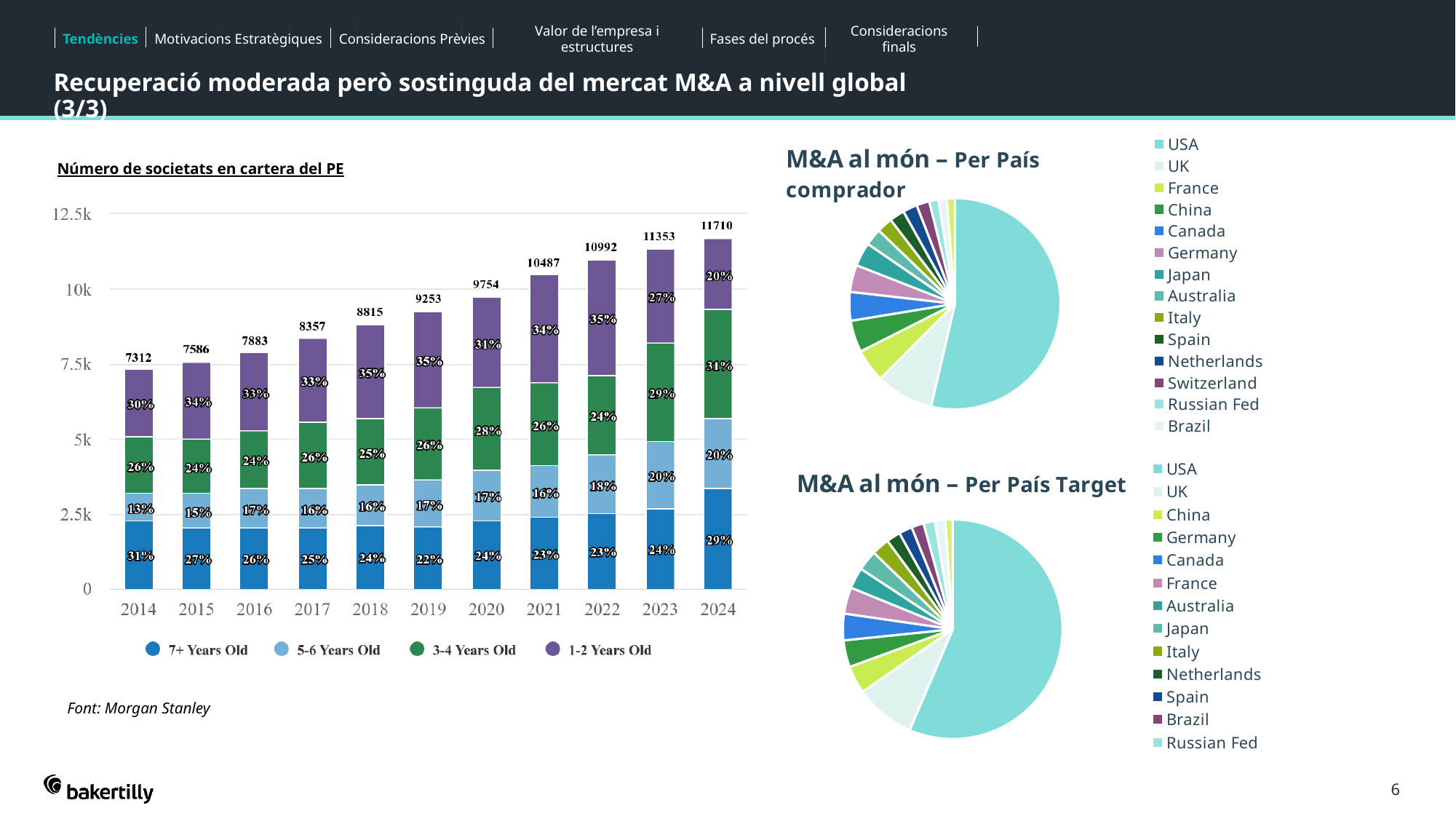
In the chart 'Número de societats en cartera del PE', what percentage does the '7+ Years Old' segment represent in 2014? 31% In the chart 'Número de societats en cartera del PE', which year has a larger total, 2019 or 2020? 2020 In the chart 'Número de societats en cartera del PE', do the yearly totals rise or fall from 2014 to 2024? Rise In the chart 'Número de societats en cartera del PE', which year has the highest total? 2024 How many series does the legend of the chart 'Número de societats en cartera del PE' list? 4 How many years are shown on the x axis of the chart 'Número de societats en cartera del PE'? 11 In the chart 'Número de societats en cartera del PE', what is the total number of companies shown for 2020? 9754 In the chart 'Número de societats en cartera del PE', what percentage does the '1-2 Years Old' segment represent in 2024? 20% In the chart 'Número de societats en cartera del PE', which year has the lowest total? 2014 In the chart 'Número de societats en cartera del PE', what is the difference between the 2024 total and the 2014 total? 4398 In the pie chart 'M&A al món – Per País comprador', which country has the largest slice? USA What kind of chart is 'Número de societats en cartera del PE'? Stacked bar chart